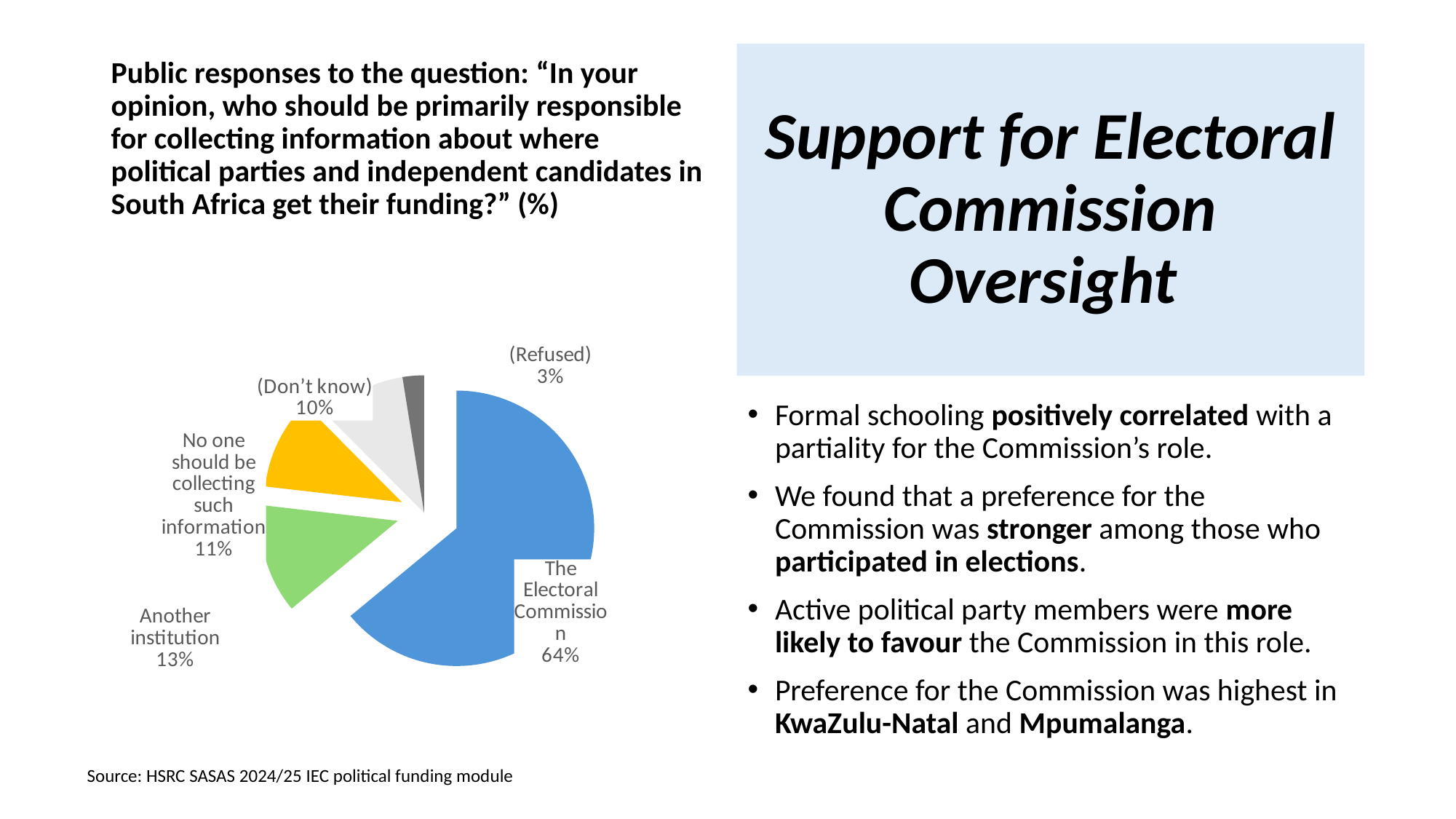
Which is larger: the share for Another institution or the share for Don't know? Another institution What kind of chart is shown on the slide? Pie chart Which response category has the largest share of the pie? The Electoral Commission What is the difference in percentage points between The Electoral Commission and Another institution? 51 What percentage of respondents said The Electoral Commission should be primarily responsible? 64% What percentage of respondents answered Don't know? 10% What percentage of respondents chose Another institution? 13% Which response category has the smallest share of the pie? (Refused) What percentage of respondents refused to answer? 3% What colour is the slice for The Electoral Commission? Blue What percentage of respondents said No one should be collecting such information? 11% How many slices does the pie chart have? 5